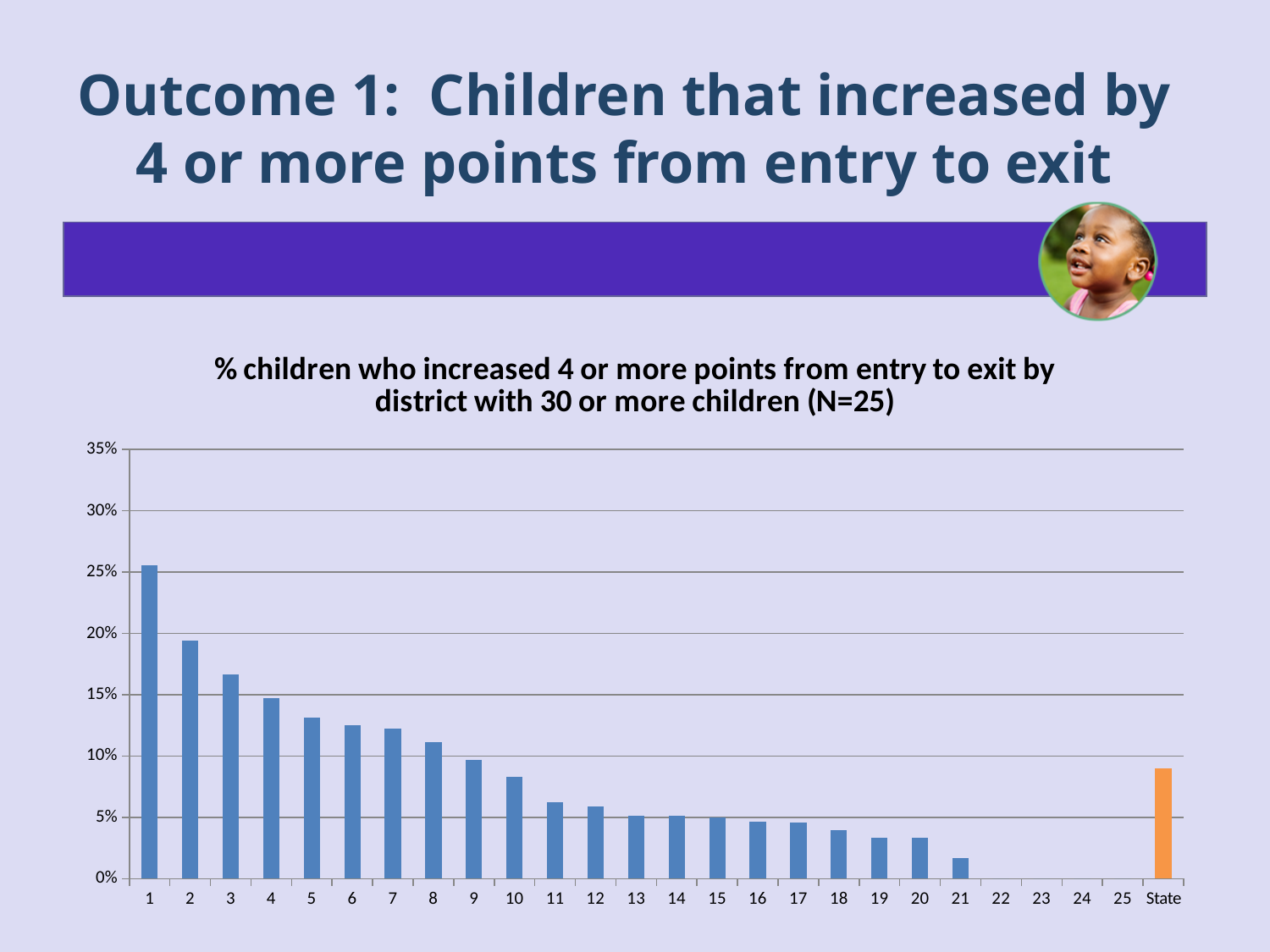
Which is larger, the value for district 3 or the value for district 8? district 3 Is the value for district 1 greater or less than 25%? greater Do the district values rise or fall moving from district 1 to district 21 along the x axis? fall Is the value for district 21 greater or less than 5%? less What kind of chart is shown on the slide? bar chart Is the State value greater or less than 10%? less What colour is the State bar? orange Which district has the highest percentage of children who increased 4 or more points? 1 How many categories are labelled on the x axis, including State? 26